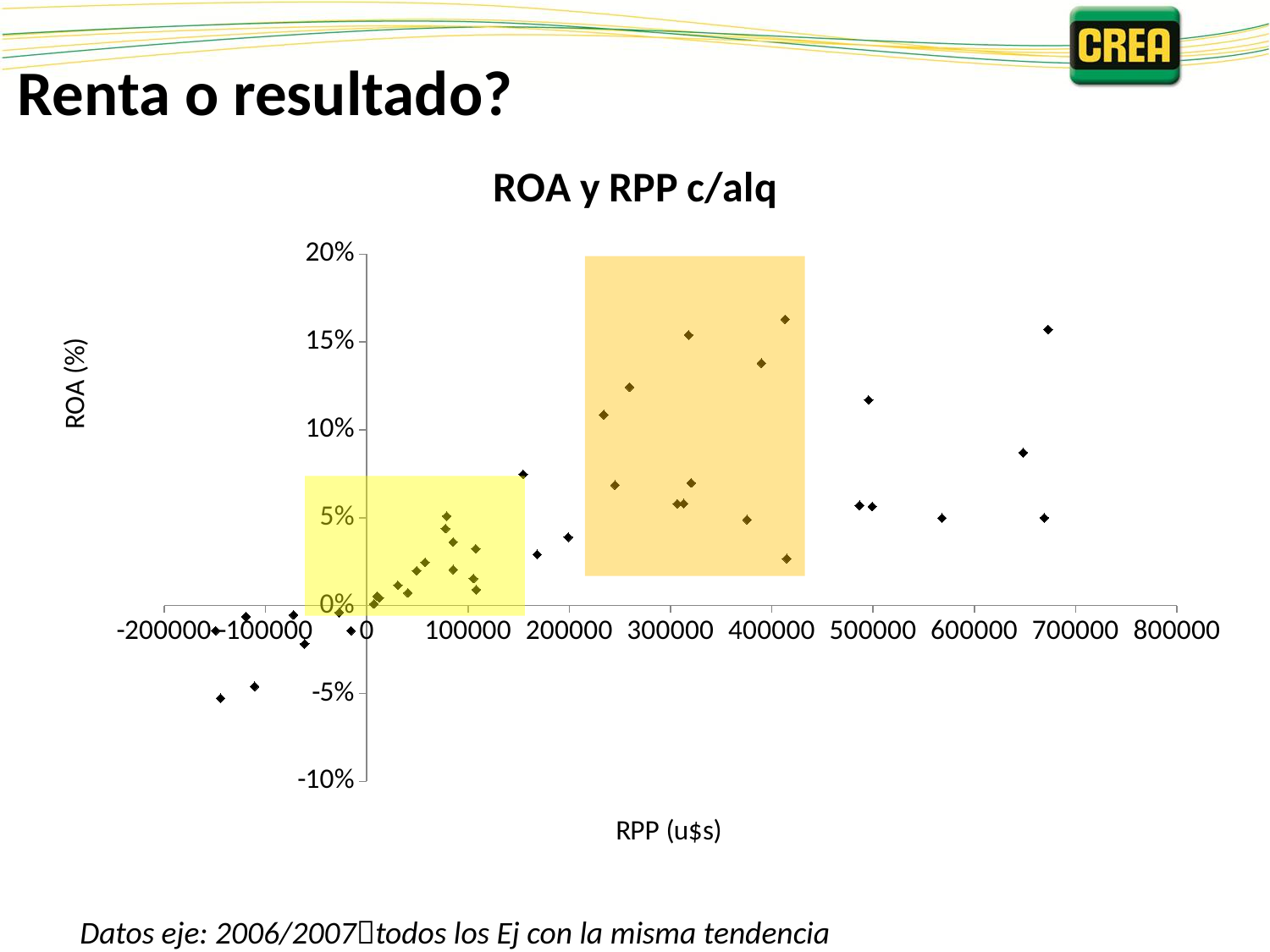
What is the maximum value shown on the horizontal axis? 800000 Is the ROA of the point with the lowest RPP (near -150000) greater or less than 0%? less What is the maximum value shown on the vertical axis? 20% What is the label of the vertical axis? ROA (%) Do the ROA values generally rise or fall as RPP increases along the x axis? rise Are the points with negative RPP values above or below 0% ROA? below What is the minimum value shown on the vertical axis? -10% What kind of chart is shown on the slide? scatter chart Is the ROA of the highest point inside the orange highlighted region greater or less than 15%? greater What is the title of the chart? ROA y RPP c/alq What is the minimum value shown on the horizontal axis? -200000